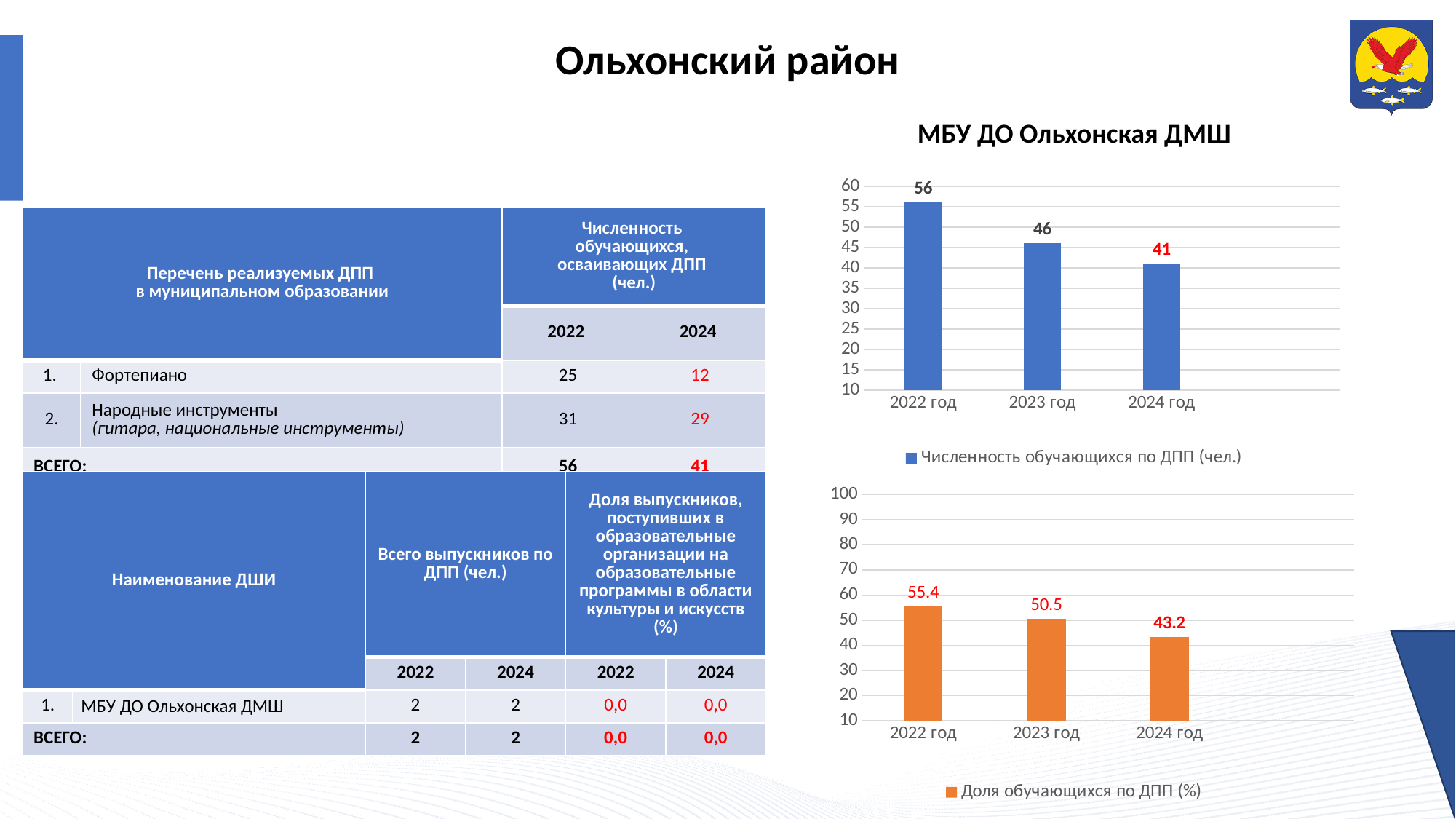
How many bars are plotted in the bottom chart (Доля обучающихся по ДПП)? 3 In the bottom chart (Доля обучающихся по ДПП), which year has the lowest value? 2024 год What type of chart is the top chart (МБУ ДО Ольхонская ДМШ)? bar chart In the bottom chart (Доля обучающихся по ДПП), which is larger: the value for 2022 год or 2023 год? 2022 год In the bottom chart (Доля обучающихся по ДПП), what is the value for 2024 год? 43.2 In the top chart (МБУ ДО Ольхонская ДМШ), do the values rise or fall from 2022 год to 2024 год? fall In the bottom chart (Доля обучающихся по ДПП), what is the value for 2023 год? 50.5 In the top chart (МБУ ДО Ольхонская ДМШ), what is the value for 2022 год? 56 In the top chart (МБУ ДО Ольхонская ДМШ), what is the difference between the values for 2022 год and 2024 год? 15 In the top chart (МБУ ДО Ольхонская ДМШ), what is the value for 2024 год? 41 In the top chart (МБУ ДО Ольхонская ДМШ), which year has the highest value? 2022 год What is the legend entry of the bottom chart? Доля обучающихся по ДПП (%)